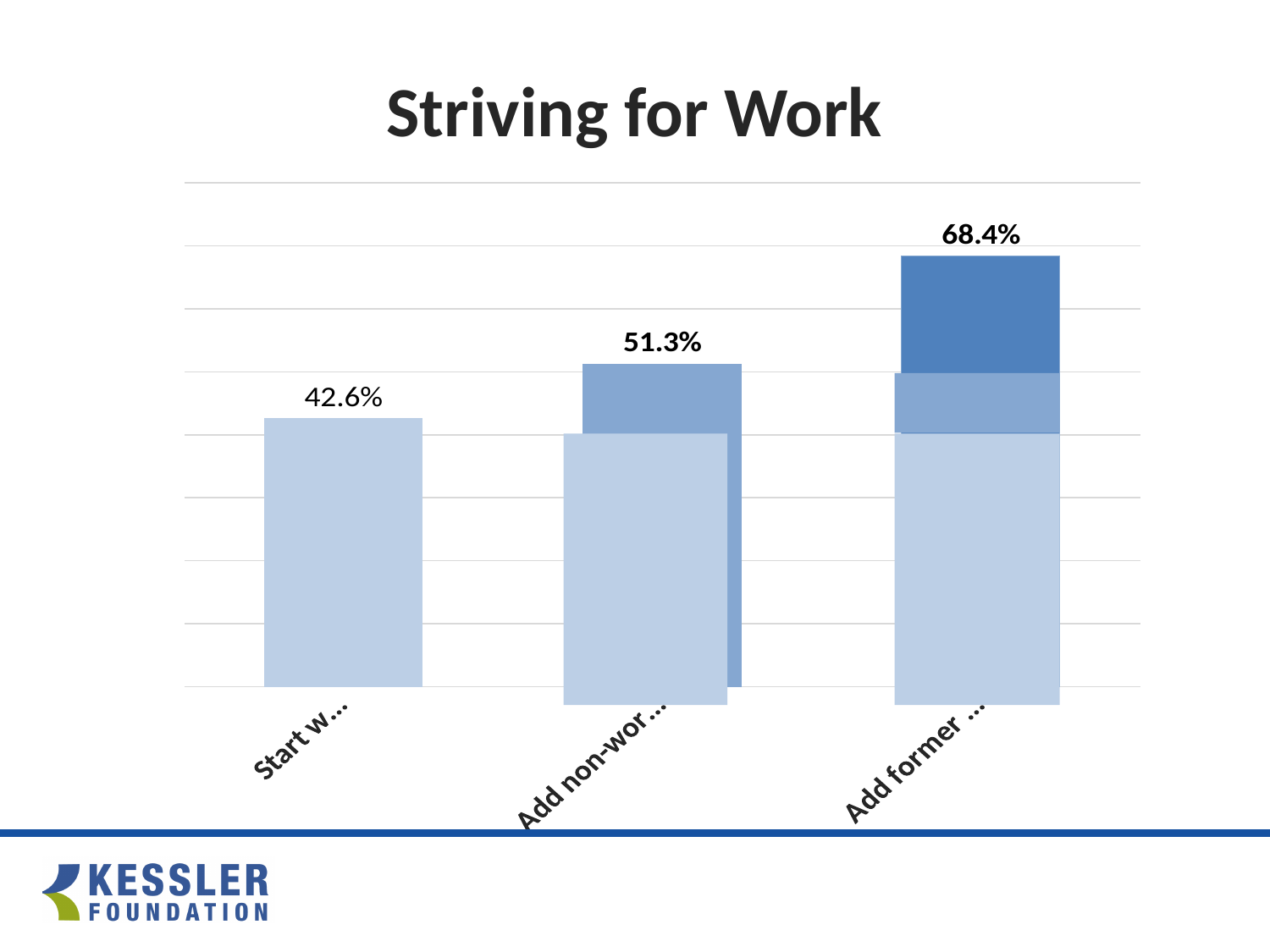
Do the labeled values rise or fall from left to right across the bars? rise What is the difference between the labeled values of the rightmost bar and the leftmost bar? 25.8 percentage points What is the title of the chart? Striving for Work Which bar has the highest labeled value? the third (rightmost) bar, 68.4% What kind of chart is shown on the slide? bar chart What value is labeled on the first (leftmost) bar? 42.6% How many bars (categories) are plotted in the chart? 3 Which is larger, the labeled value of the middle bar or the leftmost bar? the middle bar (51.3%) What value is labeled on the middle bar? 51.3% What is the difference between the labeled values of the middle bar and the leftmost bar? 8.7 percentage points Which bar has the lowest labeled value? the first (leftmost) bar, 42.6% What value is labeled on the third (rightmost) bar? 68.4%